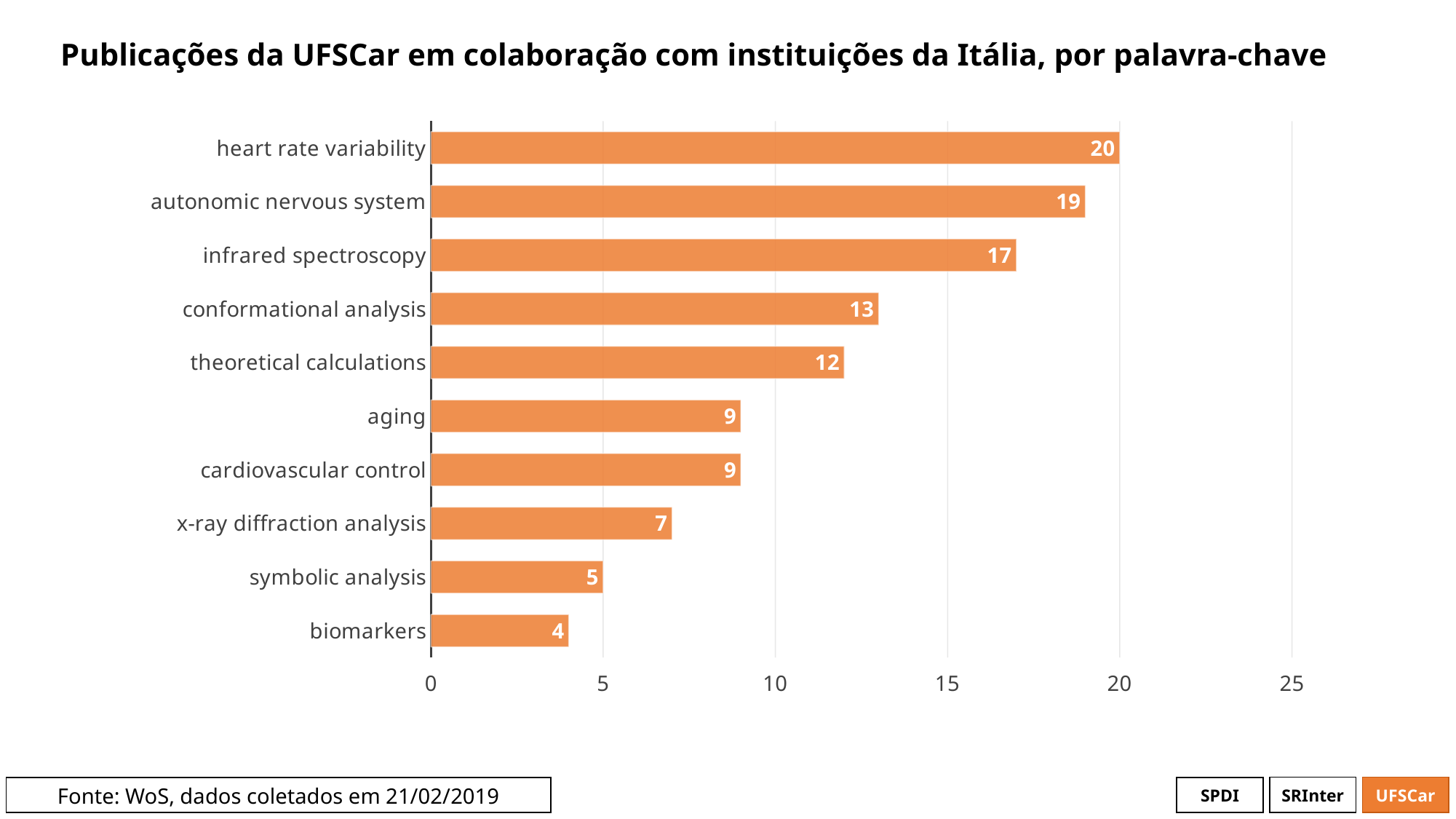
What is the value for infrared spectroscopy? 17 Is the value for symbolic analysis greater or less than 10? less What is the value for heart rate variability? 20 Which keyword has the highest number of publications? heart rate variability Which is larger, the value for autonomic nervous system or the value for infrared spectroscopy? autonomic nervous system What is the difference between the values for conformational analysis and theoretical calculations? 1 What is the title of the chart? Publicações da UFSCar em colaboração com instituições da Itália, por palavra-chave Which keyword has the lowest number of publications? biomarkers What kind of chart is shown on the slide? bar chart How many keywords are shown in the chart? 10 What is the difference between the values for heart rate variability and biomarkers? 16 What is the value for x-ray diffraction analysis? 7